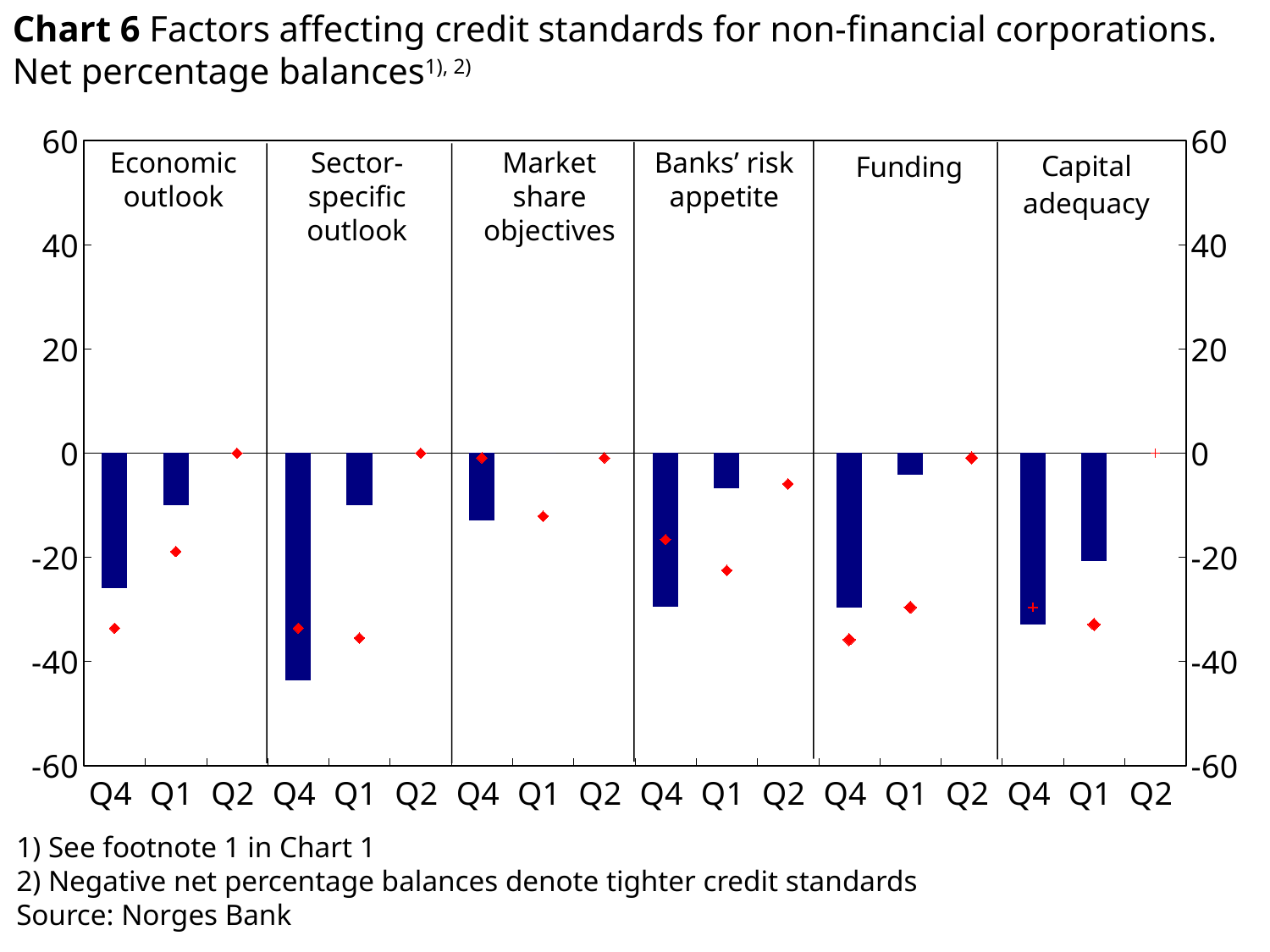
What kind of chart is shown on the slide? bar chart Which factor has the lowest (most negative) bar for Q4? Sector-specific outlook What is the source given for the chart? Norges Bank Is the Q4 bar for Market share objectives greater or less than -20? greater For Economic outlook, which bar is larger (less negative), Q4 or Q1? Q1 For Economic outlook, do the bars rise or fall from Q4 to Q2? rise How many factors (panels) are shown in the chart? 6 Is the Q1 bar for Banks' risk appetite greater or less than -20? greater Is the Q4 bar for Sector-specific outlook greater or less than -40? less How many quarters are shown for each factor? 3